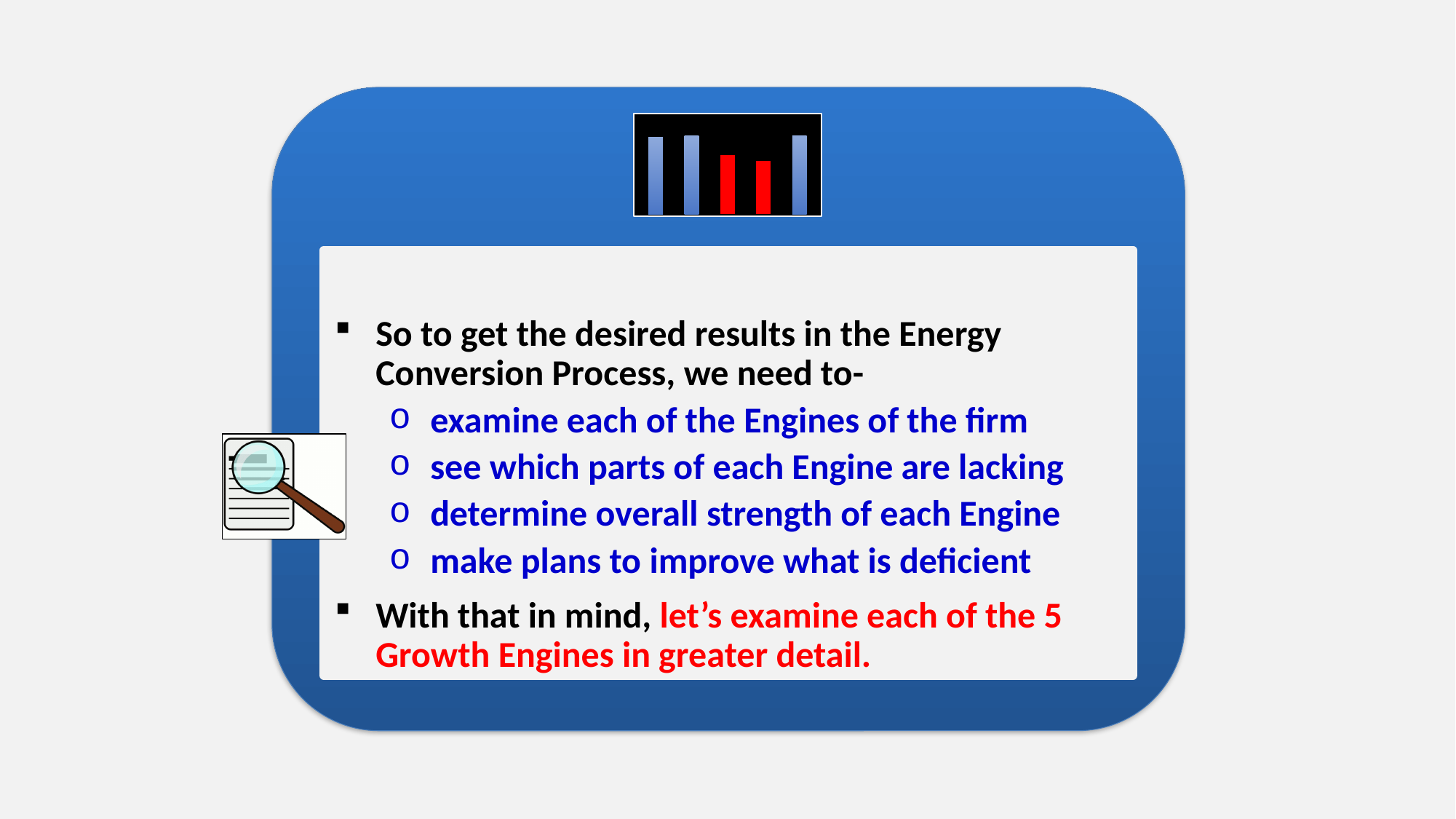
In the small chart at the top of the slide, are the red bars taller or shorter than the blue bars? shorter What is the background colour of the small chart at the top of the slide? black What kind of chart is shown in the small graphic at the top of the slide? bar chart How many bars does the small chart at the top of the slide contain? 5 In the small chart at the top of the slide, how many bars are red? 2